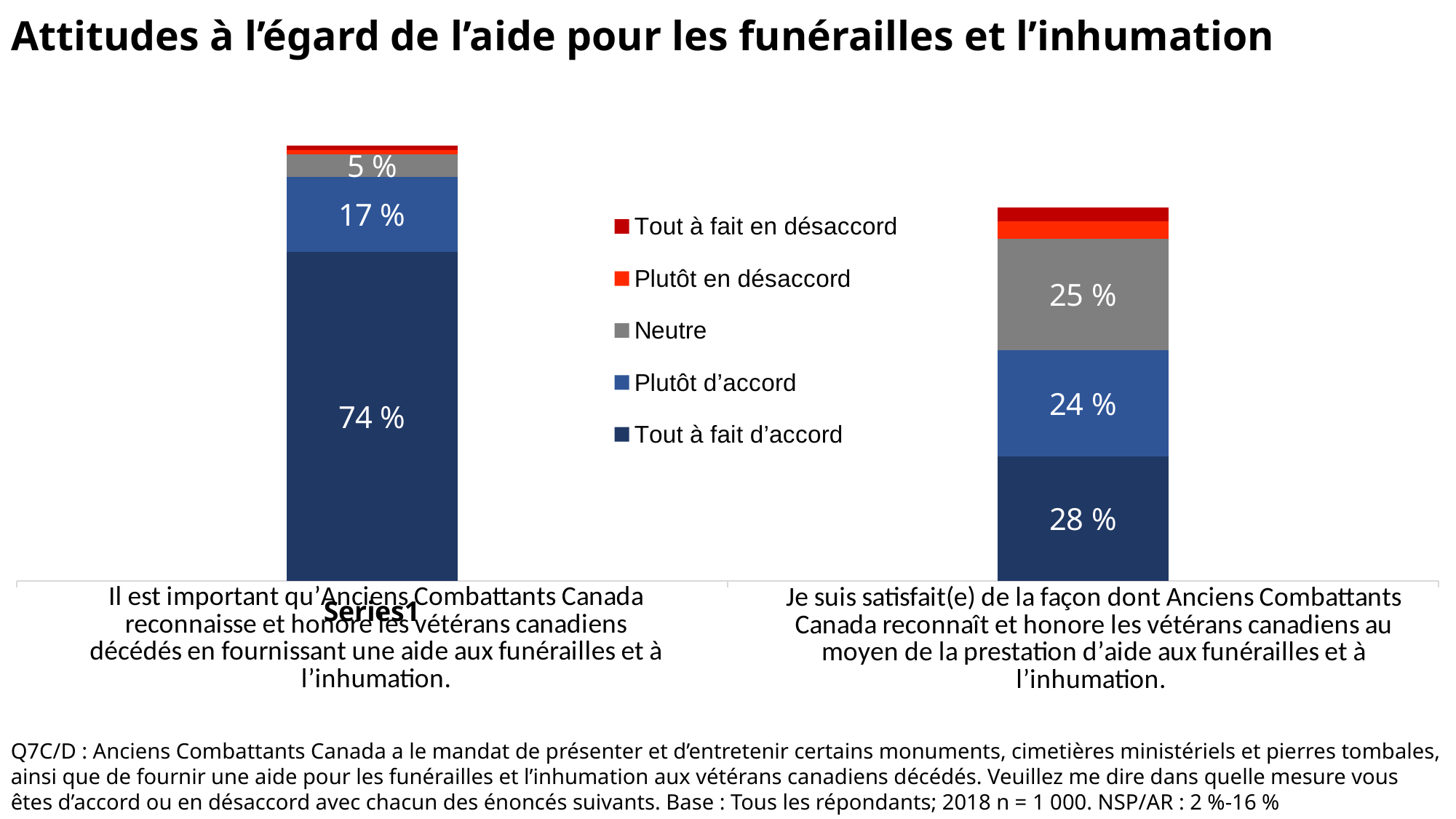
What is the "Neutre" value for the right bar (satisfaction statement)? 25 % What is the "Plutôt d'accord" value for the satisfaction statement (right bar)? 24 % What colour represents "Neutre" in the legend? Grey What is the "Plutôt d'accord" value for the left bar (importance statement)? 17 % What is the difference in percentage points between the "Tout à fait d'accord" values of the left bar and the right bar? 46 Which response category is the largest segment in the left bar? Tout à fait d'accord How many series does the legend list? 5 What percentage answered "Tout à fait d'accord" to the satisfaction statement (right bar)? 28 % Which bar has the larger "Neutre" share, the left (importance) bar or the right (satisfaction) bar? The right (satisfaction) bar What type of chart is shown on the slide? Stacked bar chart How many stacked bars (statements) are shown in the chart? 2 What percentage of respondents answered "Tout à fait d'accord" to the statement that it is important for Anciens Combattants Canada to recognize and honour deceased veterans (left bar)? 74 %